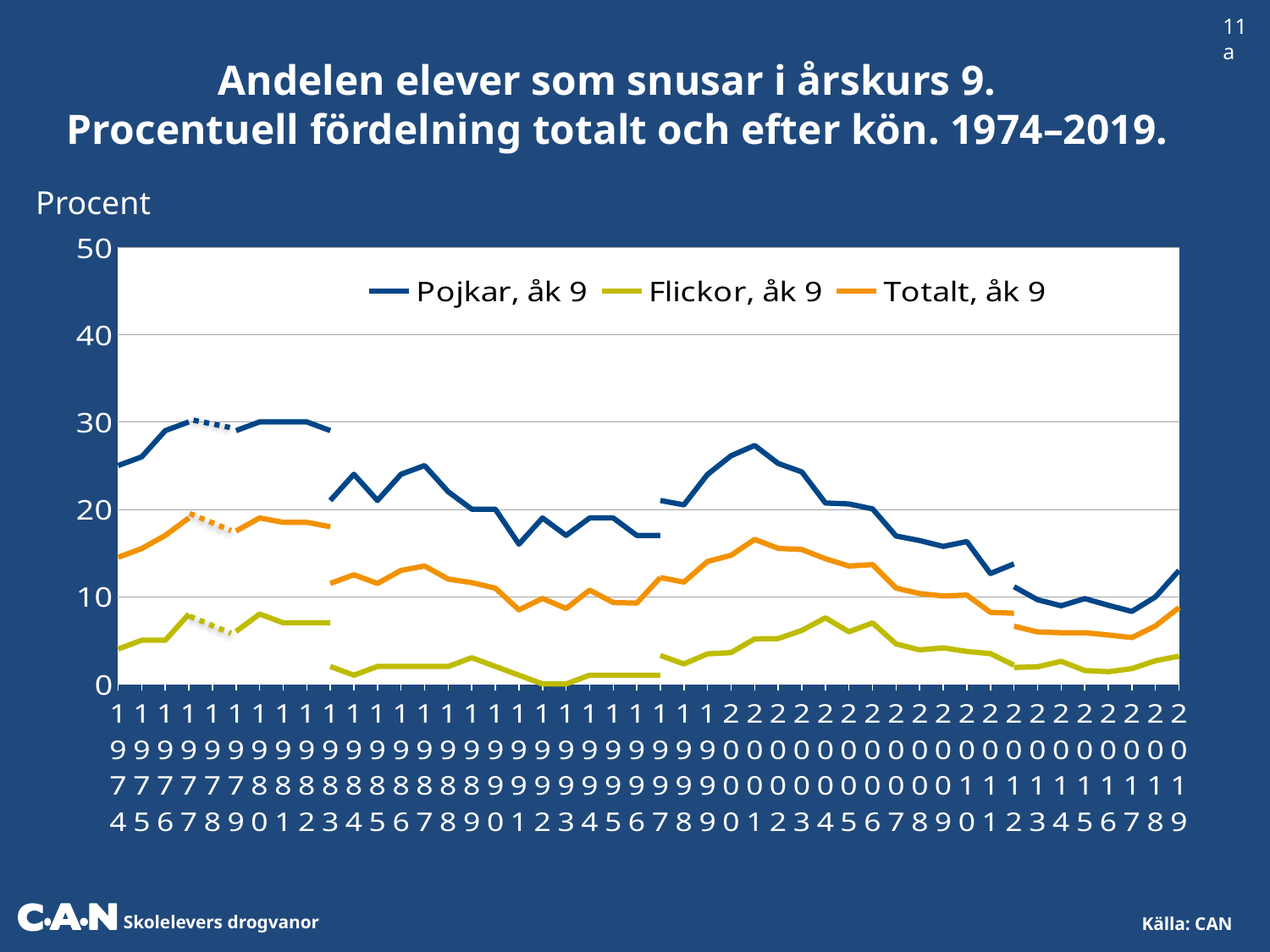
How many series does the legend list? 3 What kind of chart is shown on the slide? line chart Which series has the highest values throughout the period? Pojkar, åk 9 Is the value for Flickor, åk 9 in 1974 greater or less than 10? less Which series are listed in the legend? Pojkar, åk 9; Flickor, åk 9; Totalt, åk 9 Is the value for Pojkar, åk 9 in 1974 greater or less than 20? greater How many years are shown along the x axis? 46 Which series has the lowest values throughout the period? Flickor, åk 9 Does the value for Pojkar, åk 9 rise or fall between 2001 and 2012? fall What is the label on the vertical axis? Procent Is the value for Totalt, åk 9 in 1974 greater or less than 10? greater